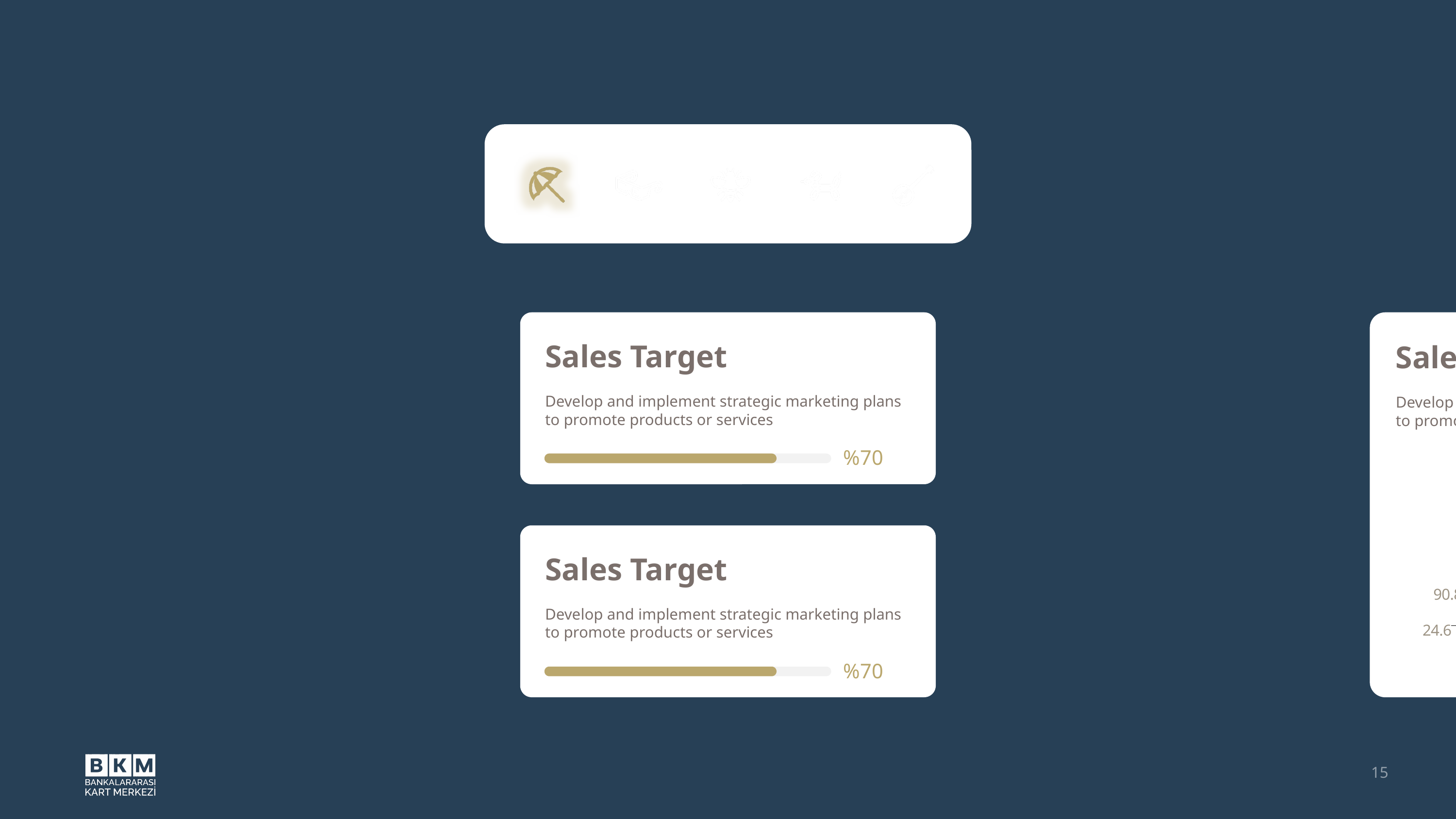
What is the difference between the values of the upper and lower "Sales Target" progress bars? 0 What value is printed next to the progress bar in the lower "Sales Target" card? %70 Do the upper and lower "Sales Target" progress bars show the same value or different values? the same value Is the value shown on the upper "Sales Target" progress bar greater or less than 50? greater What colour is the filled portion of the progress bars in the "Sales Target" cards? gold What value is printed next to the progress bar in the upper "Sales Target" card? %70 Is the value shown on the lower "Sales Target" progress bar greater or less than 100? less What is the title of the card containing the upper progress bar? Sales Target How many fully visible "Sales Target" cards with progress bars are on the slide? 2